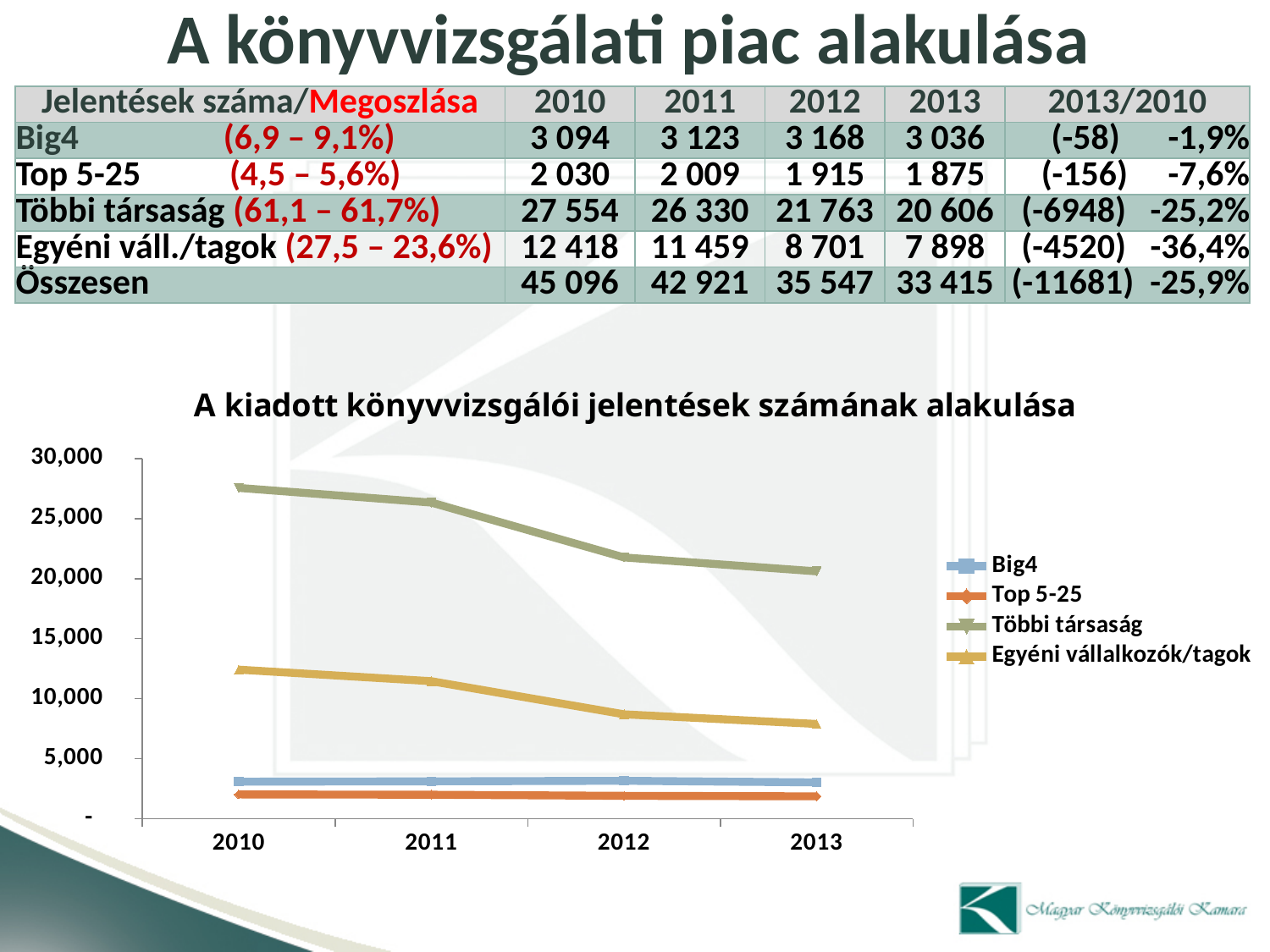
Which series has the lowest values in the chart? Top 5-25 How many series does the chart legend list? 4 What is the title of the chart? A kiadott könyvvizsgálói jelentések számának alakulása Which series has the highest values in the chart? Többi társaság What kind of chart is shown on the slide? line chart Is the value for Egyéni vállalkozók/tagok in 2013 greater or less than 10,000? less According to the table, what is the value for Többi társaság in 2013? 20 606 How many years are plotted along the x axis of the chart? 4 Is the value for Big4 in 2011 greater or less than 5,000? less In 2012, which is larger: Big4 or Top 5-25? Big4 Does the Többi társaság line rise or fall from 2010 to 2013? fall Is the value for Többi társaság in 2010 greater or less than 25,000? greater